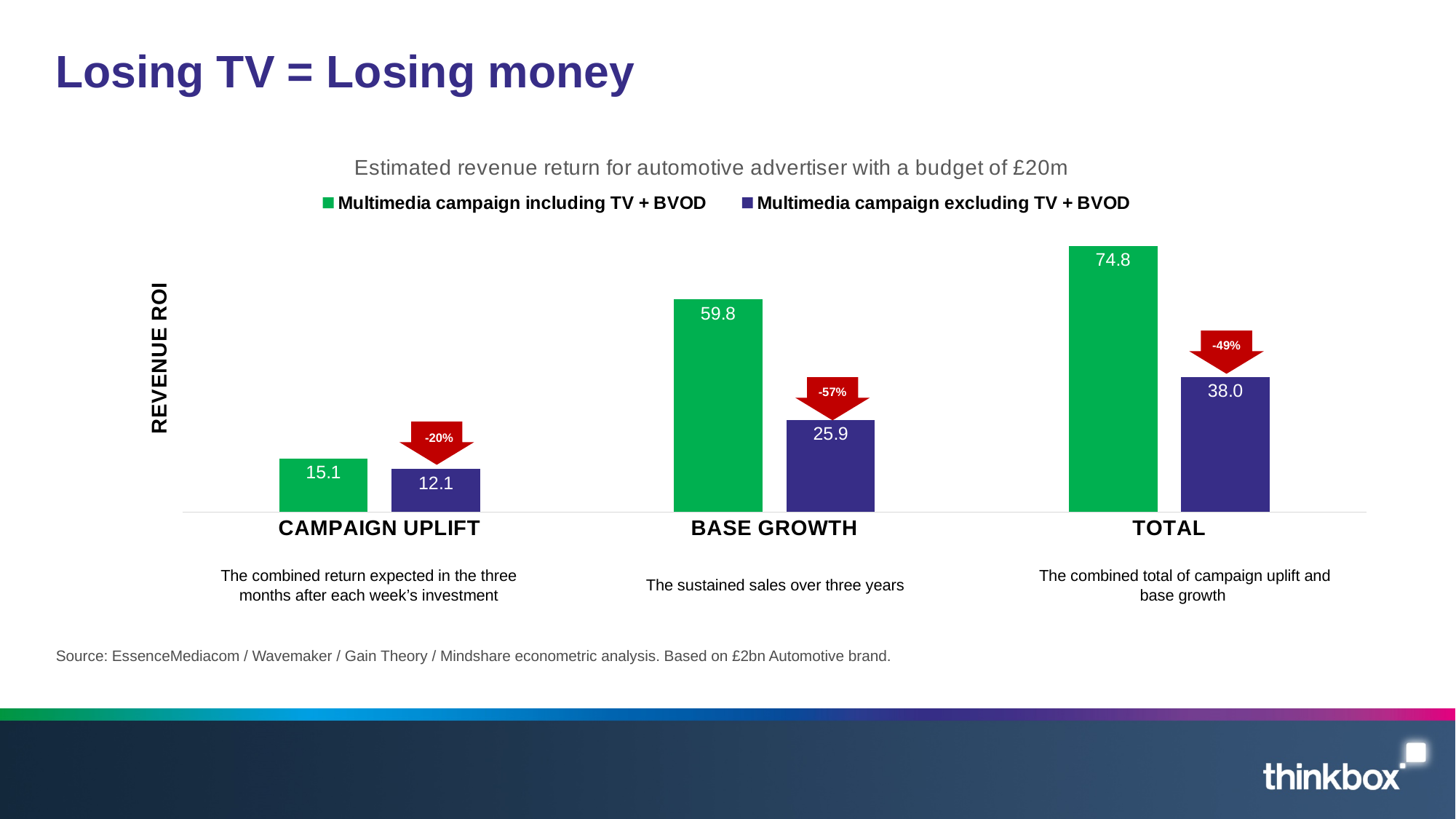
What is the revenue ROI for the multimedia campaign excluding TV + BVOD for Base Growth? 25.9 Which category has the lowest value for the multimedia campaign excluding TV + BVOD? Campaign Uplift What is the Campaign Uplift value for the multimedia campaign including TV + BVOD? 15.1 What is the difference between the including TV + BVOD and excluding TV + BVOD values for Base Growth? 33.9 How many categories are shown on the x axis of the chart? 3 What type of chart is shown on the slide? Bar chart What percentage decrease is shown by the red arrow above the Total category's excluding TV + BVOD bar? -49% What is the revenue ROI for the multimedia campaign including TV + BVOD in the Total category? 74.8 For Campaign Uplift, which series has the larger value: including TV + BVOD or excluding TV + BVOD? Multimedia campaign including TV + BVOD Which category has the highest value for the multimedia campaign including TV + BVOD? Total How many series does the chart legend list? 2 What is the difference between the two series' values in the Total category? 36.8